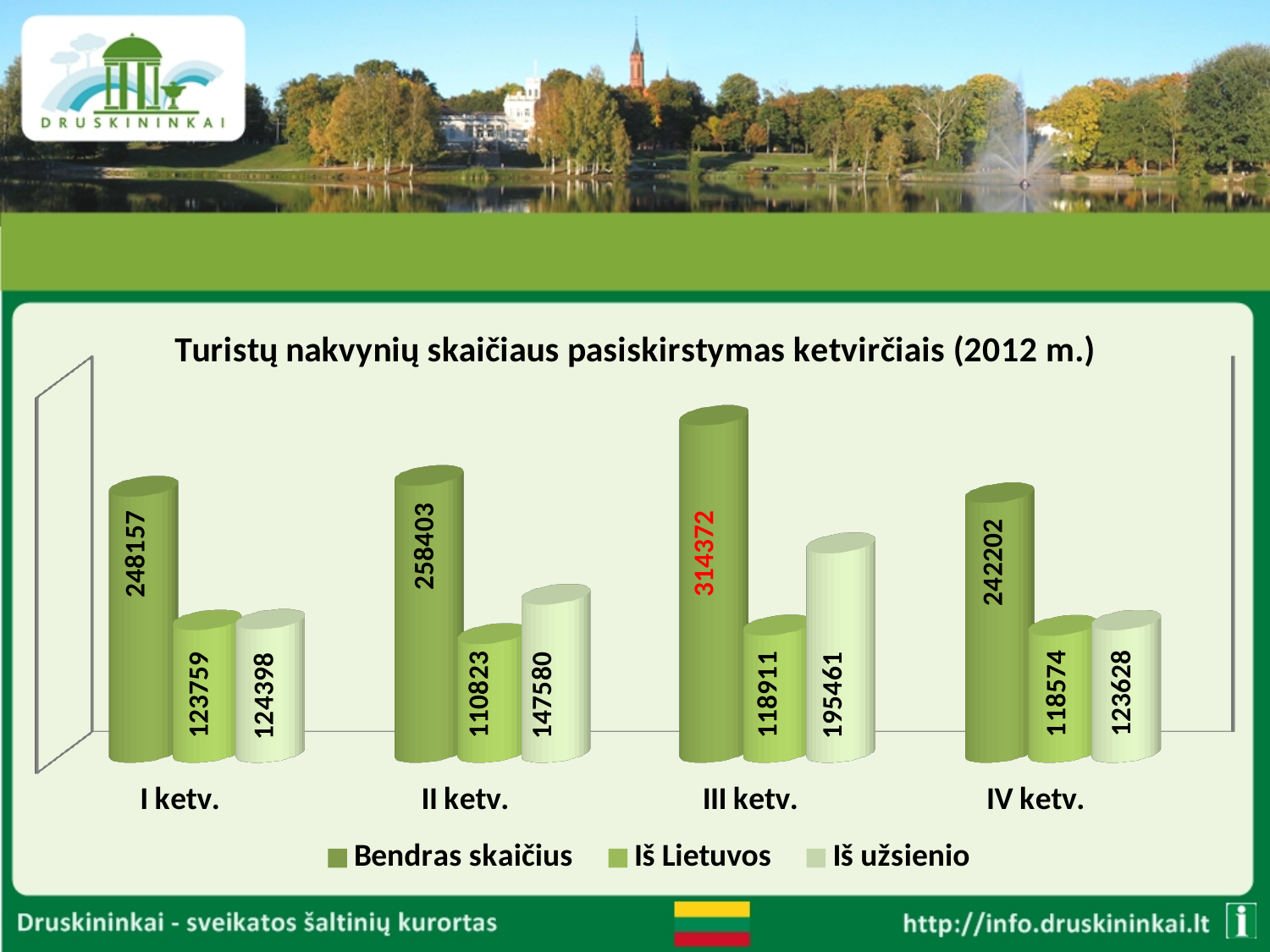
How many series does the legend list? 3 What is the difference between Iš užsienio and Iš Lietuvos for III ketv.? 76550 Which quarter has the highest Bendras skaičius value? III ketv. Which quarter has the lowest Bendras skaičius value? IV ketv. What is the value of Bendras skaičius for I ketv.? 248157 What kind of chart is shown on the slide? Bar chart What is the difference between Bendras skaičius for III ketv. and I ketv.? 66215 What is the value of Iš Lietuvos for IV ketv.? 118574 Which quarter has the lowest Iš Lietuvos value? II ketv. Which is larger for II ketv.: Iš Lietuvos or Iš užsienio? Iš užsienio What is the value of Iš užsienio for II ketv.? 147580 What is the value of Bendras skaičius for III ketv.? 314372